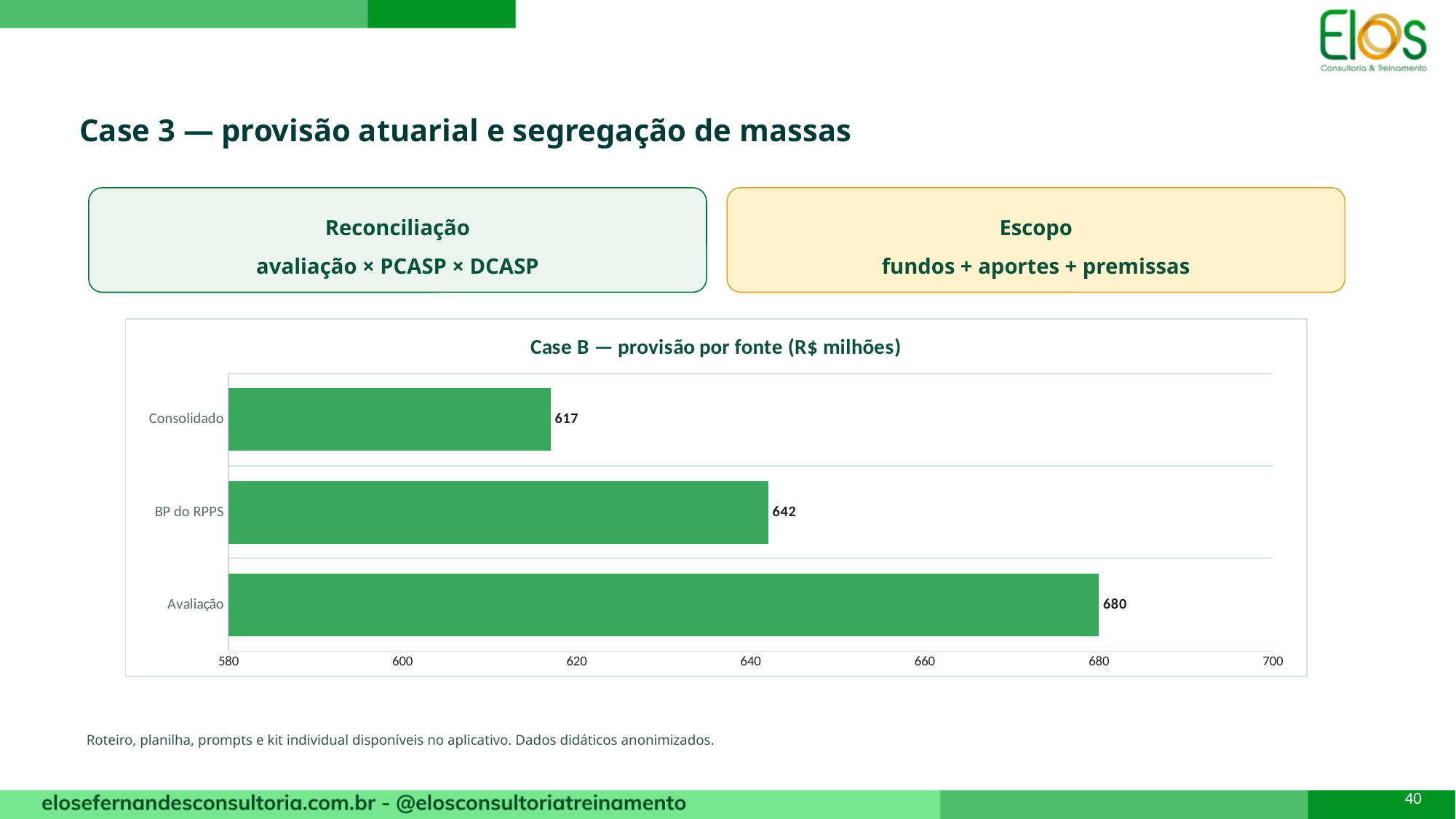
Which category has the lowest value? Consolidado What is the difference between the values for BP do RPPS and Consolidado? 25 What is the value for Avaliação in the chart? 680 What is the value for Consolidado in the chart? 617 Which is larger, the value for BP do RPPS or the value for Consolidado? BP do RPPS Which category has the highest value? Avaliação What is the value for BP do RPPS in the chart? 642 Is the value for BP do RPPS greater or less than 660? less What is the difference between the values for Avaliação and Consolidado? 63 What is the title of the chart? Case B — provisão por fonte (R$ milhões) What kind of chart is shown on the slide? bar chart How many categories are shown in the chart? 3